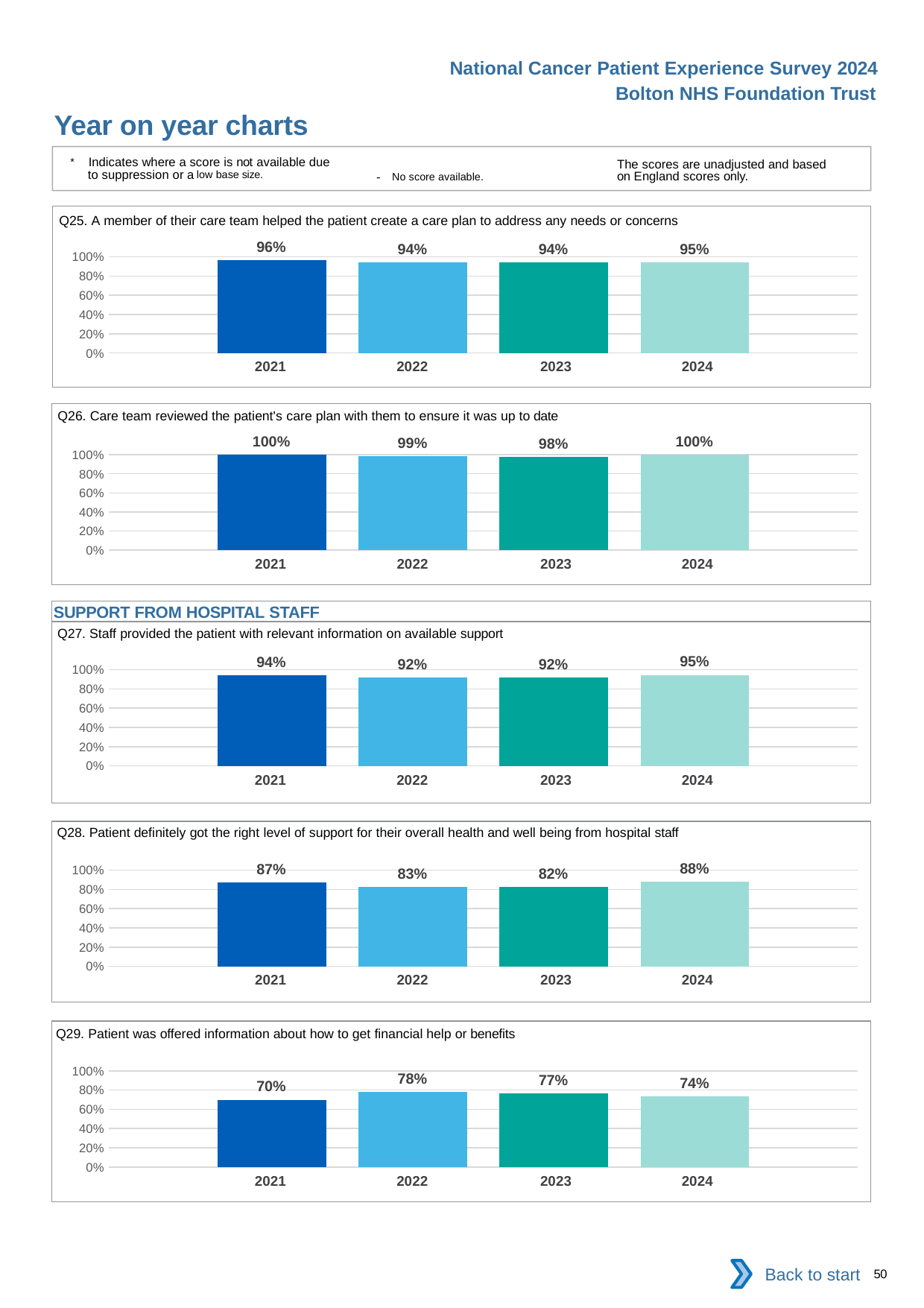
In the Q27 chart, what is the difference between the 2024 and 2023 values? 3% In the Q28 chart, is the value for 2022 larger or smaller than the value for 2021? smaller How many years are shown in the Q25 chart? 4 In the Q29 chart, what is the value for 2022? 78% What kind of chart is the Q26 chart? bar chart In the Q29 chart, which year has the lowest value? 2021 In the Q28 chart, which year has the highest value? 2024 In the Q28 chart, what is the difference between the 2024 and 2023 values? 6% In the Q25 chart, what is the value for 2021? 96% In the Q26 chart, which year has the lowest value? 2023 In the Q29 chart, is the value for 2021 greater or less than 80%? less What is the section heading shown above the Q27 chart? SUPPORT FROM HOSPITAL STAFF